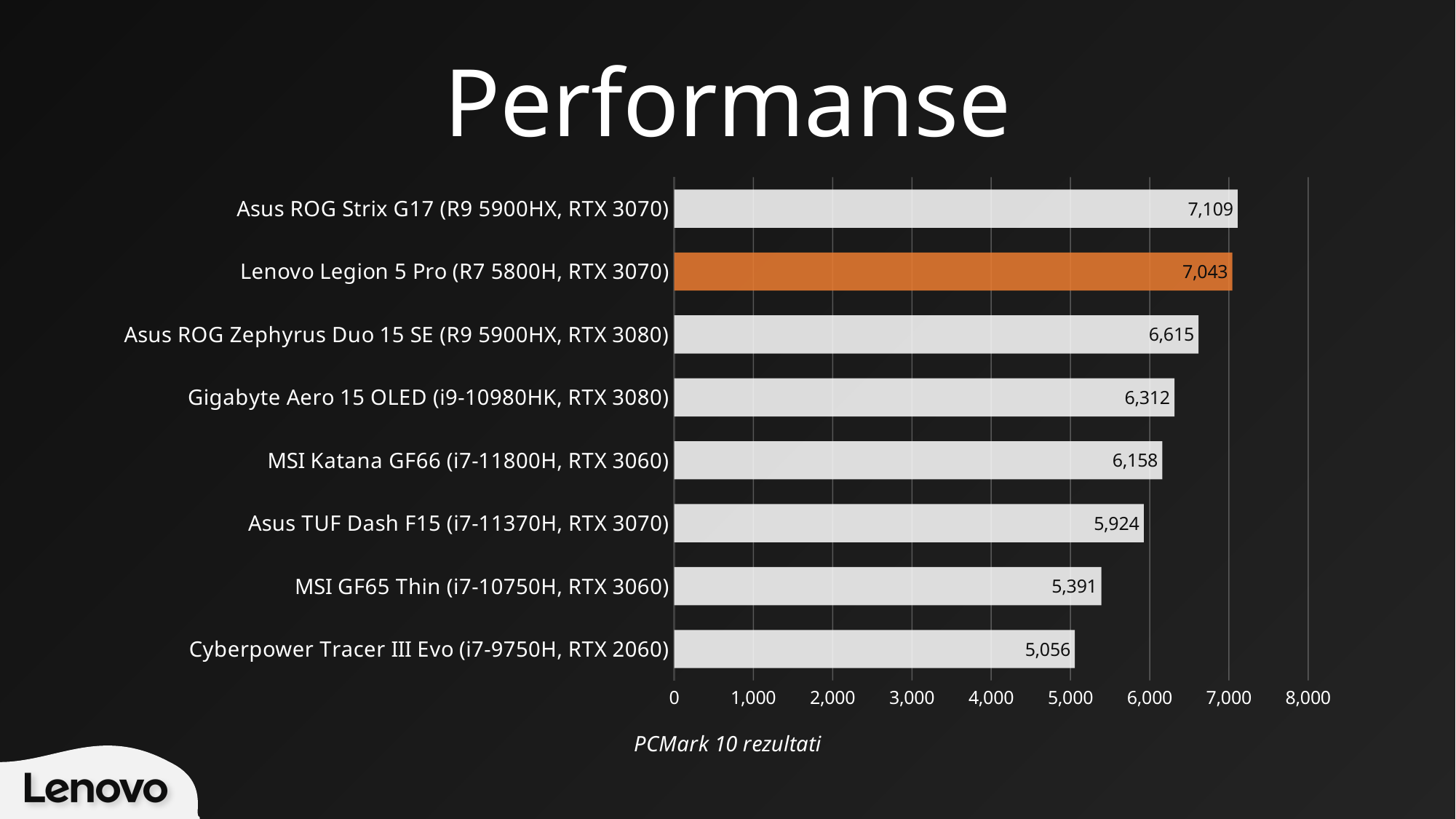
What is the difference between the PCMark 10 scores of the Asus TUF Dash F15 and the MSI GF65 Thin? 533 Which has a higher PCMark 10 score, the Gigabyte Aero 15 OLED or the Asus ROG Zephyrus Duo 15 SE? Asus ROG Zephyrus Duo 15 SE What is the PCMark 10 score for the Lenovo Legion 5 Pro (R7 5800H, RTX 3070)? 7,043 Which laptop's bar is highlighted in orange? Lenovo Legion 5 Pro (R7 5800H, RTX 3070) What is the PCMark 10 score for the Cyberpower Tracer III Evo (i7-9750H, RTX 2060)? 5,056 What is the difference between the PCMark 10 scores of the Asus ROG Strix G17 and the Lenovo Legion 5 Pro? 66 Is the PCMark 10 score for the MSI GF65 Thin greater or less than 6,000? less What is the PCMark 10 score for the MSI Katana GF66 (i7-11800H, RTX 3060)? 6,158 How many laptops are compared in the chart? 8 Which laptop has the lowest PCMark 10 score? Cyberpower Tracer III Evo (i7-9750H, RTX 2060) What kind of chart is shown on the slide? Bar chart Which laptop has the highest PCMark 10 score? Asus ROG Strix G17 (R9 5900HX, RTX 3070)